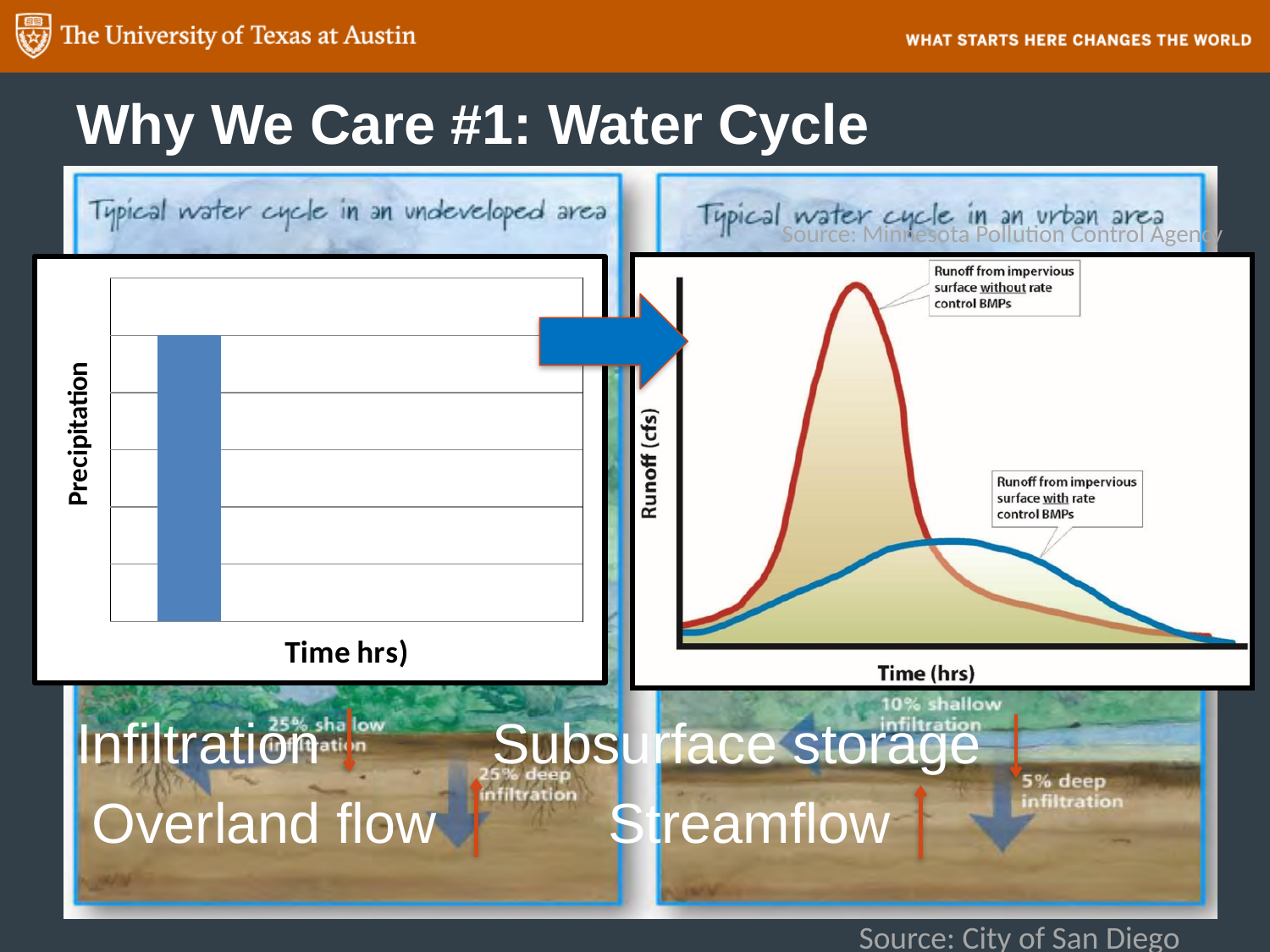
What kind of chart is the chart on the right of the slide? line chart In the right chart, does the runoff without rate control BMPs rise and then fall, or rise steadily, along the time axis? rise and then fall How many curves are plotted in the right chart? 2 What kind of chart is the chart on the left of the slide? bar chart What is the y-axis label of the right chart? Runoff (cfs) What is the y-axis label of the left chart? Precipitation In the right chart, which curve has the lowest peak? Runoff from impervious surface with rate control BMPs In the right chart, which curve reaches the higher peak: runoff from impervious surface without rate control BMPs or with rate control BMPs? Runoff from impervious surface without rate control BMPs How many bars are plotted in the left chart? 1